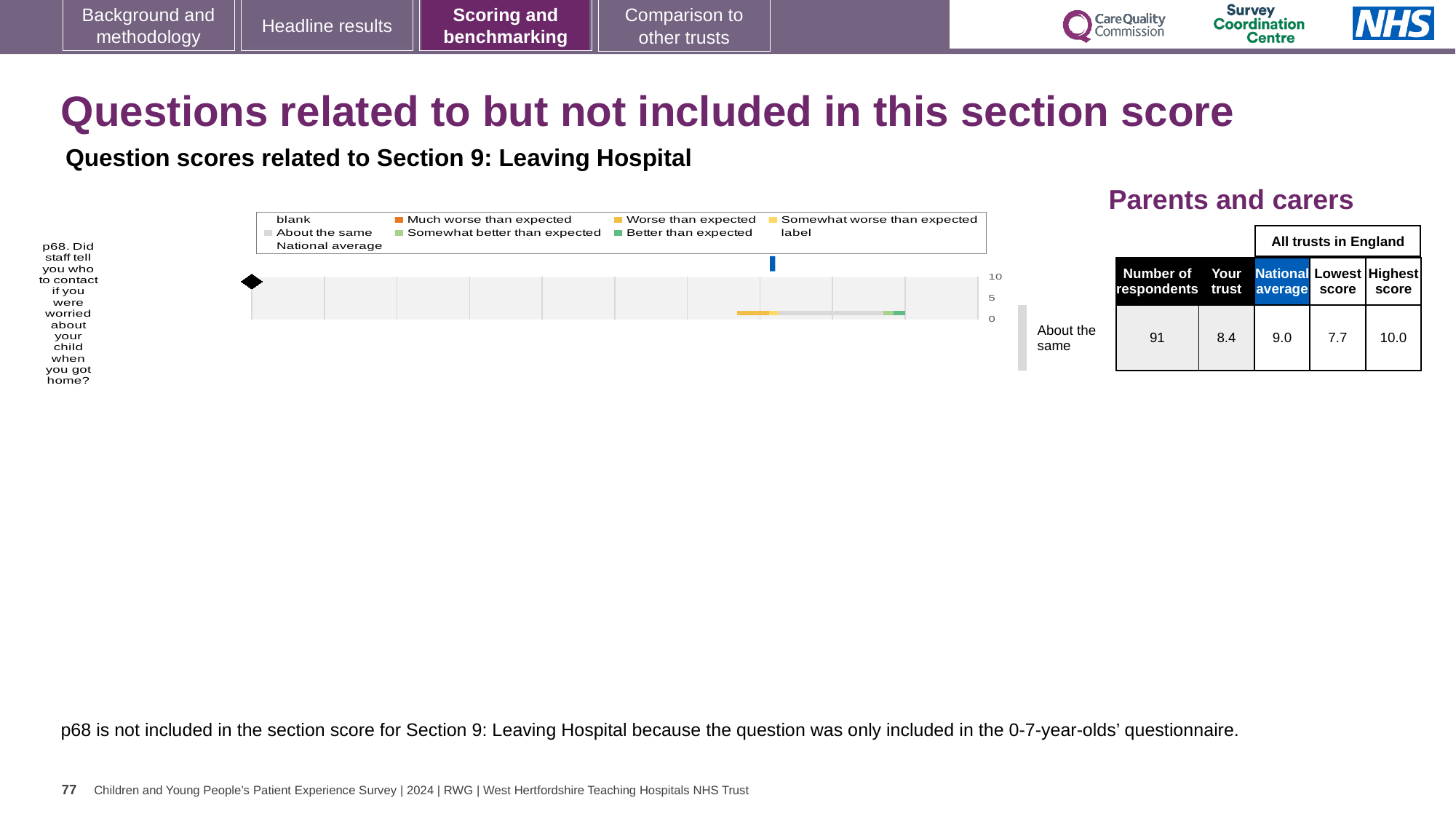
According to the table beside the chart, what is the 'Your trust' score for p68? 8.4 According to the table beside the chart, what is the highest score among all trusts in England for p68? 10.0 What benchmark category is the trust's p68 score placed in, as labelled next to the chart? About the same Which is larger for p68, the 'Your trust' score or the national average? National average What is the question number of the item plotted in the chart? p68 What is the highest value shown on the chart's axis? 10 What kind of chart is shown on the slide? bar chart What is the difference between the national average and the 'Your trust' score for p68? 0.6 How many questions are plotted in the chart? 1 According to the table beside the chart, what is the lowest score among all trusts in England for p68? 7.7 According to the table beside the chart, what is the national average score for p68? 9.0 How many respondents answered p68 according to the table beside the chart? 91